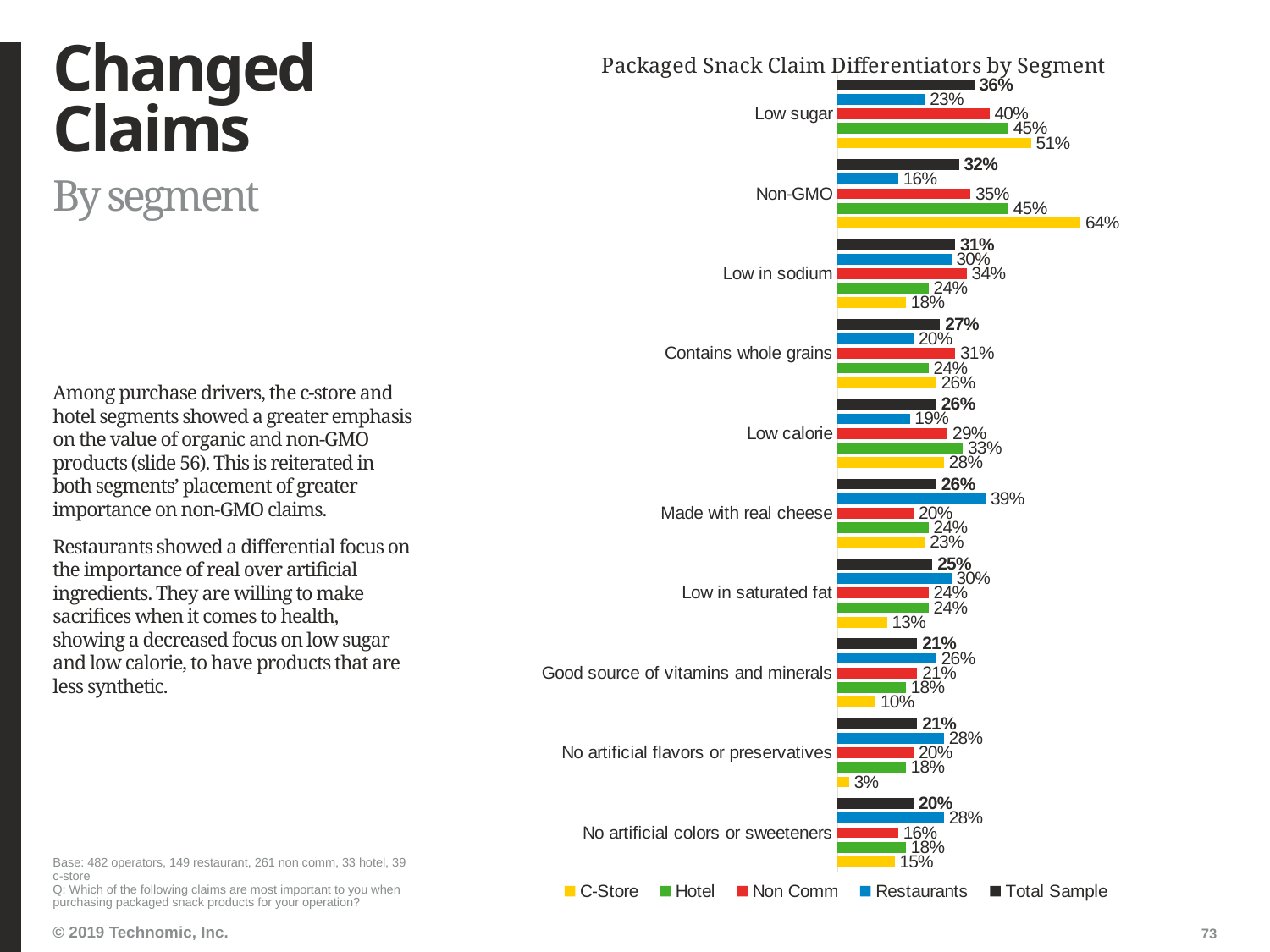
Which claim has the highest Total Sample value? Low sugar What is the C-Store value for Non-GMO? 64% What is the title of the chart? Packaged Snack Claim Differentiators by Segment How many claims are listed on the chart? 10 What is the Total Sample value for Low sugar? 36% What is the C-Store value for No artificial flavors or preservatives? 3% What is the difference between the C-Store and Restaurants values for Non-GMO? 48 percentage points What is the Restaurants value for Made with real cheese? 39% What kind of chart is shown on the slide? Bar chart For Low in sodium, which is larger: the Non Comm value or the Hotel value? Non Comm How many series does the legend list? 5 Which claim has the lowest C-Store value? No artificial flavors or preservatives